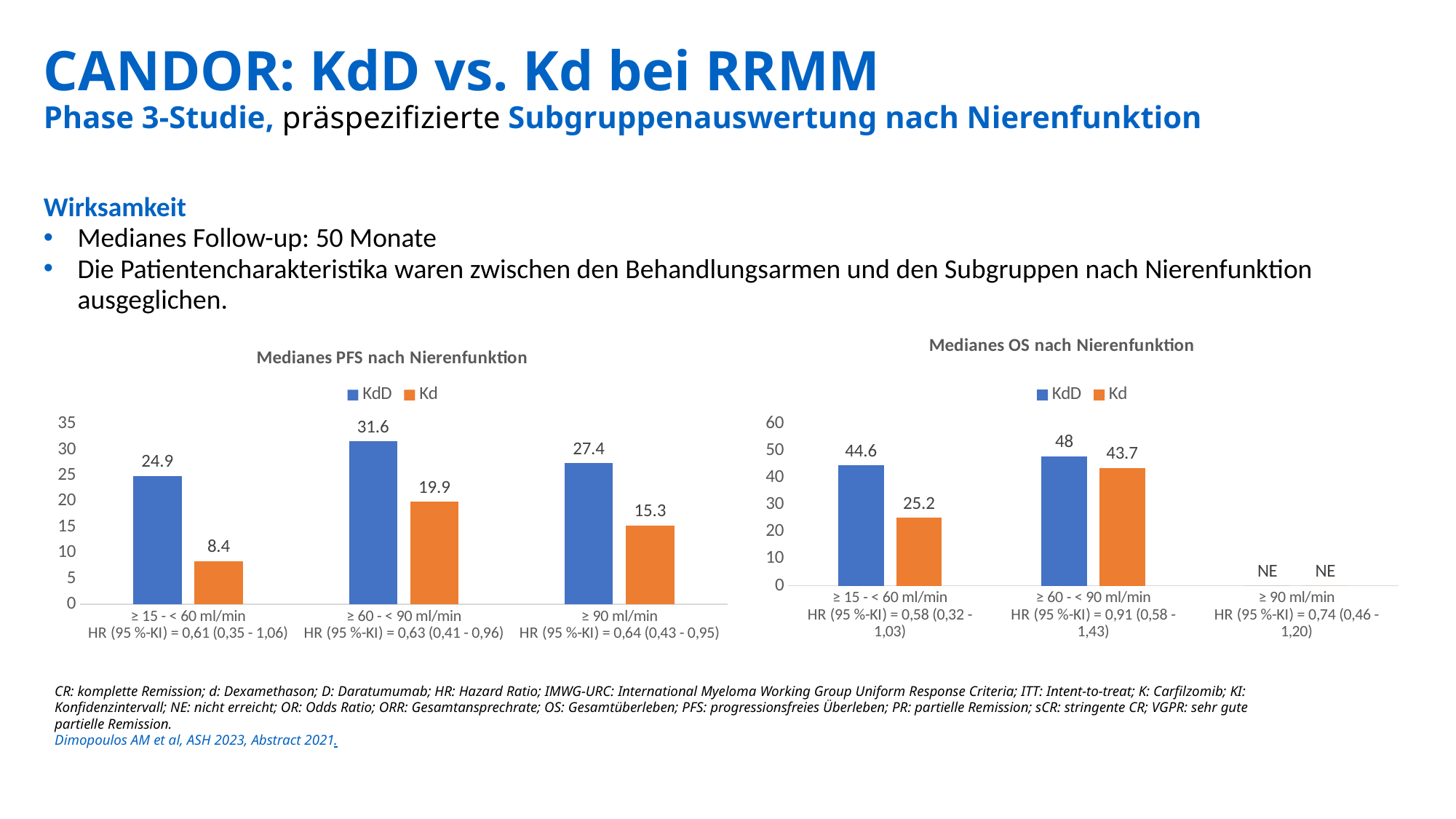
In the 'Medianes PFS nach Nierenfunktion' chart, which renal function group has the lowest Kd value? ≥ 15 - < 60 ml/min In the 'Medianes OS nach Nierenfunktion' chart, what is shown for the ≥ 90 ml/min group? NE In the 'Medianes PFS nach Nierenfunktion' chart, what is the Kd value for the ≥ 15 - < 60 ml/min group? 8.4 In the 'Medianes OS nach Nierenfunktion' chart, what is the Kd value for the ≥ 60 - < 90 ml/min group? 43.7 In the 'Medianes OS nach Nierenfunktion' chart, what is the KdD value for the ≥ 15 - < 60 ml/min group? 44.6 What type of chart is 'Medianes OS nach Nierenfunktion'? Bar chart In the 'Medianes OS nach Nierenfunktion' chart, what is the difference between the KdD and Kd values for the ≥ 15 - < 60 ml/min group? 19.4 In the 'Medianes PFS nach Nierenfunktion' chart, what is the KdD value for the ≥ 60 - < 90 ml/min group? 31.6 In the 'Medianes PFS nach Nierenfunktion' chart, how many series does the legend list? 2 In the 'Medianes PFS nach Nierenfunktion' chart, what is the difference between the KdD and Kd values for the ≥ 90 ml/min group? 12.1 In the 'Medianes PFS nach Nierenfunktion' chart, which renal function group has the highest KdD value? ≥ 60 - < 90 ml/min In the 'Medianes OS nach Nierenfunktion' chart, which is larger for the ≥ 15 - < 60 ml/min group, KdD or Kd? KdD